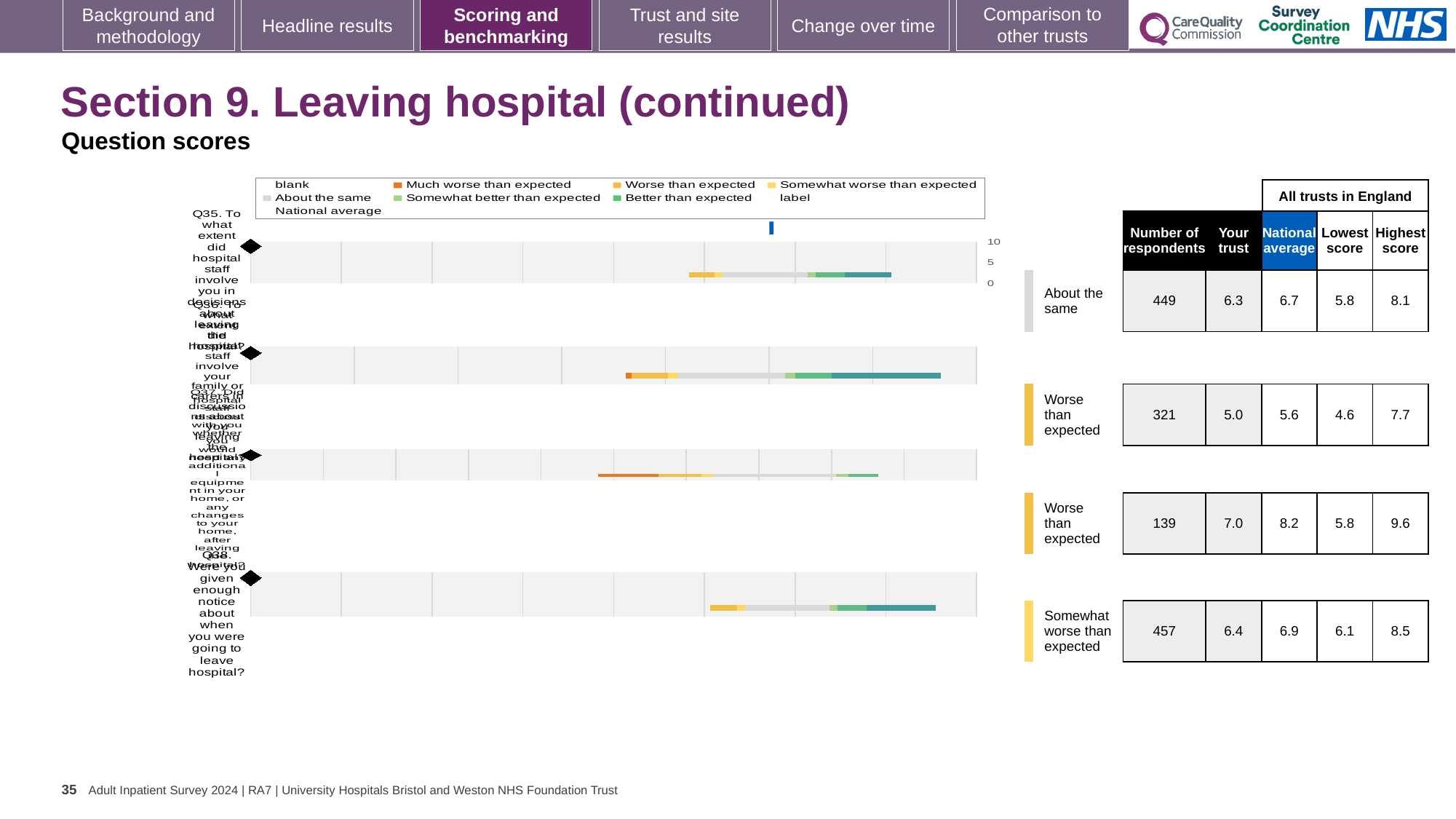
Which row has the lowest 'Your trust' score? the second row (5.0) What is the difference between the national average and the 'Your trust' score for Q35? 0.4 What is the national average score for Q35? 6.7 What kind of chart is used to show the question scores on this slide? bar chart Which question has the highest number of respondents? Q38 Which benchmark category is Q35 placed in? About the same What is the lowest score among all trusts in England for Q35? 5.8 How many questions are plotted in the question scores chart? 4 What is the 'Your trust' score for Q35 (To what extent did hospital staff involve you in decisions about leaving hospital?)? 6.3 For Q38, which is larger: the 'Your trust' score or the national average? national average How many respondents answered Q38 (Were you given enough notice about when you were going to leave hospital?)? 457 What is the highest score among all trusts in England for Q38? 8.5